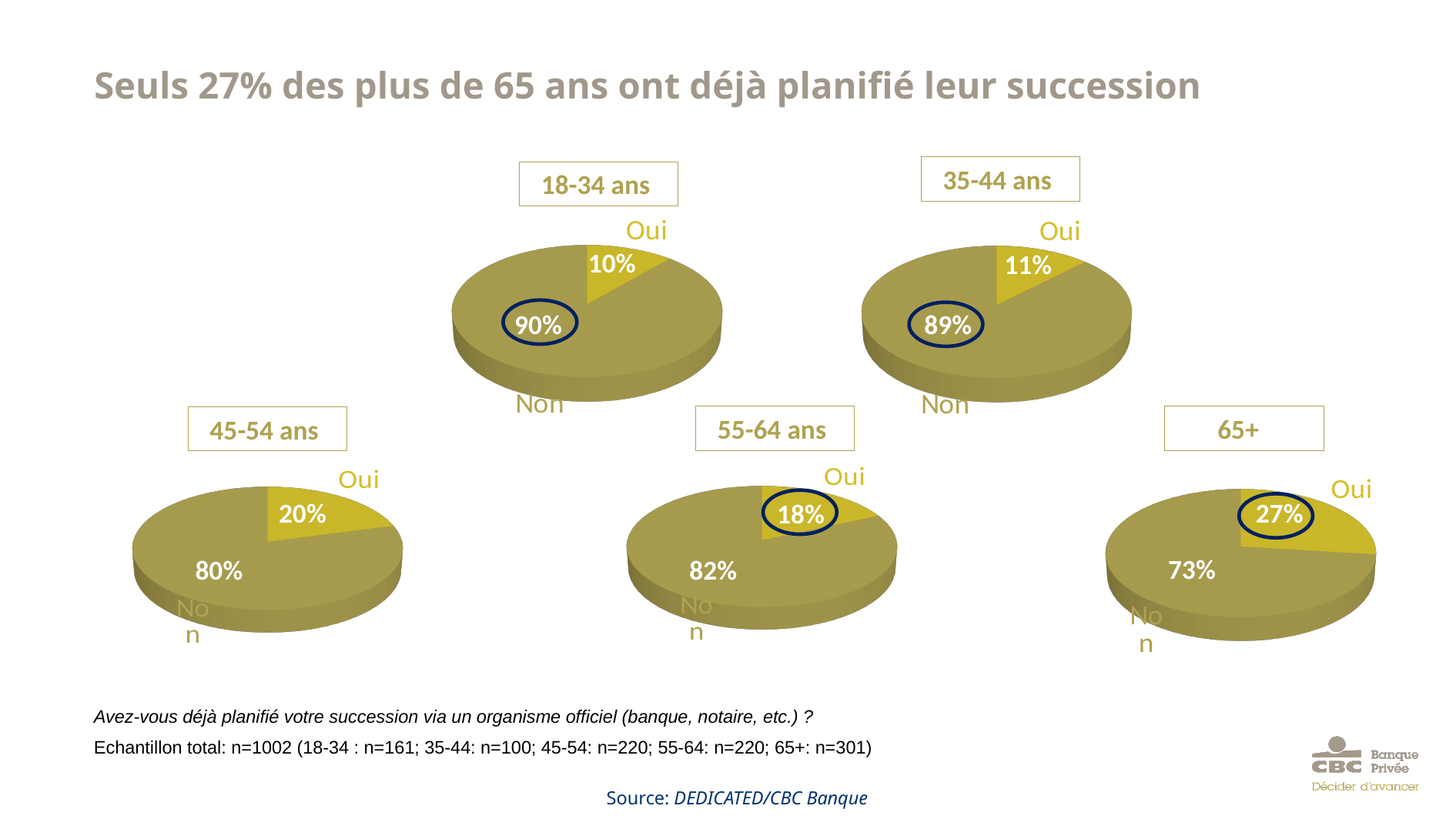
In the 18-34 ans chart, what percentage answered Oui? 10% How many pie charts are on the slide? 5 Which is larger: the Oui share in the 45-54 ans chart or the Oui share in the 55-64 ans chart? 45-54 ans What is the difference between the Oui share in the 65+ chart and the Oui share in the 18-34 ans chart? 17% In the 45-54 ans chart, what percentage answered Oui? 20% In the 65+ chart, what percentage answered Oui? 27% In the 65+ chart, what share of the pie does the Non slice represent? 73% Across the five charts, which age group has the lowest share of Oui? 18-34 ans In the 55-64 ans chart, what percentage answered Non? 82% What kind of chart is used on this slide? Pie chart Across the five charts, which age group has the highest share of Oui? 65+ In the 35-44 ans chart, what percentage answered Non? 89%